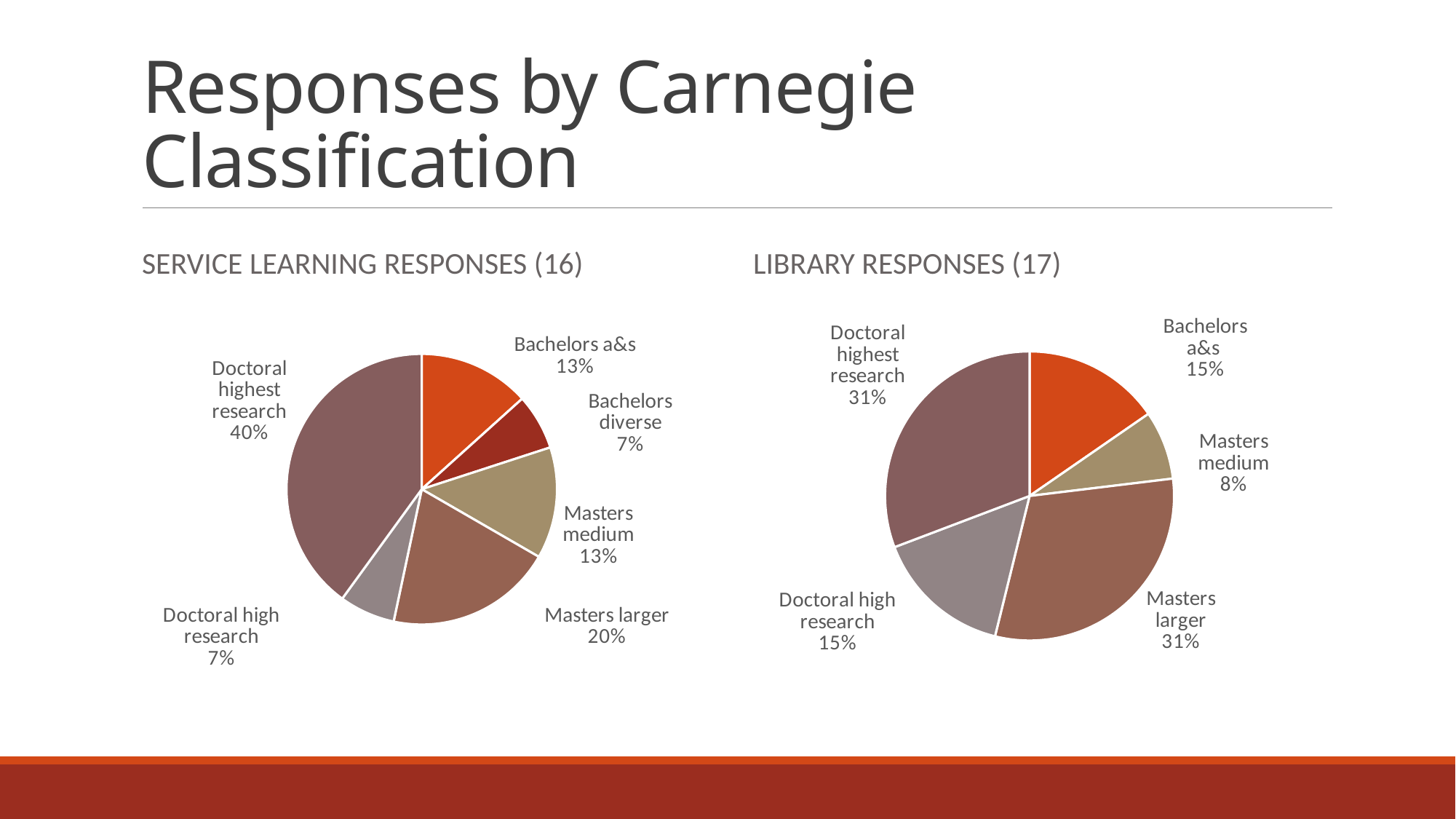
In the Library Responses chart, which category has the smallest slice? Masters medium In the Library Responses chart, what share does Masters larger have? 31% In the Service Learning Responses chart, how many categories are shown? 6 In the Service Learning Responses chart, what share does Doctoral high research have? 7% In the Library Responses chart, how many categories are shown? 5 In the Library Responses chart, what is the difference between Doctoral highest research and Doctoral high research? 16% In the Service Learning Responses chart, what share does Doctoral highest research have? 40% What kind of chart is the Service Learning Responses chart? Pie chart In the Library Responses chart, which is larger: Bachelors a&s or Masters medium? Bachelors a&s In the Service Learning Responses chart, which category has the largest slice? Doctoral highest research In the Service Learning Responses chart, what is the difference between Masters larger and Masters medium? 7% What is the title of the chart on the right side of the slide? Library Responses (17)